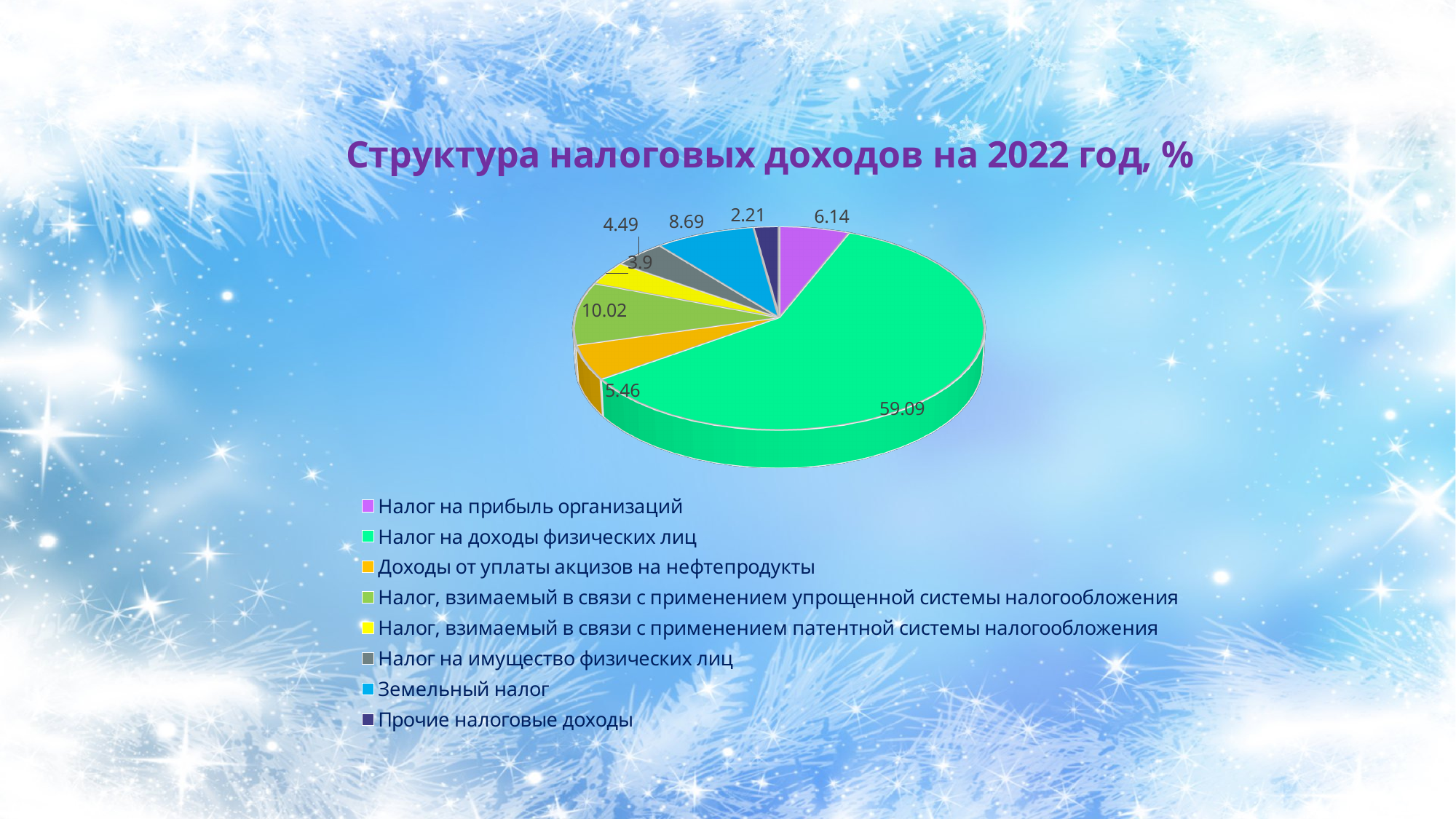
What is the value for Налог на доходы физических лиц? 59.09 How many categories does the legend list? 8 What is the difference between the values for Налог на прибыль организаций and Доходы от уплаты акцизов на нефтепродукты? 0.68 What is the title of the chart? Структура налоговых доходов на 2022 год, % What is the value for Земельный налог? 8.69 Which category has the largest share of the pie? Налог на доходы физических лиц What type of chart is shown on the slide? pie chart What is the value for Прочие налоговые доходы? 2.21 What colour is the slice for Земельный налог? blue Which is larger: the value for Налог на имущество физических лиц or the value for Налог, взимаемый в связи с применением патентной системы налогообложения? Налог на имущество физических лиц What is the value for Налог, взимаемый в связи с применением упрощенной системы налогообложения? 10.02 Which category has the smallest share of the pie? Прочие налоговые доходы